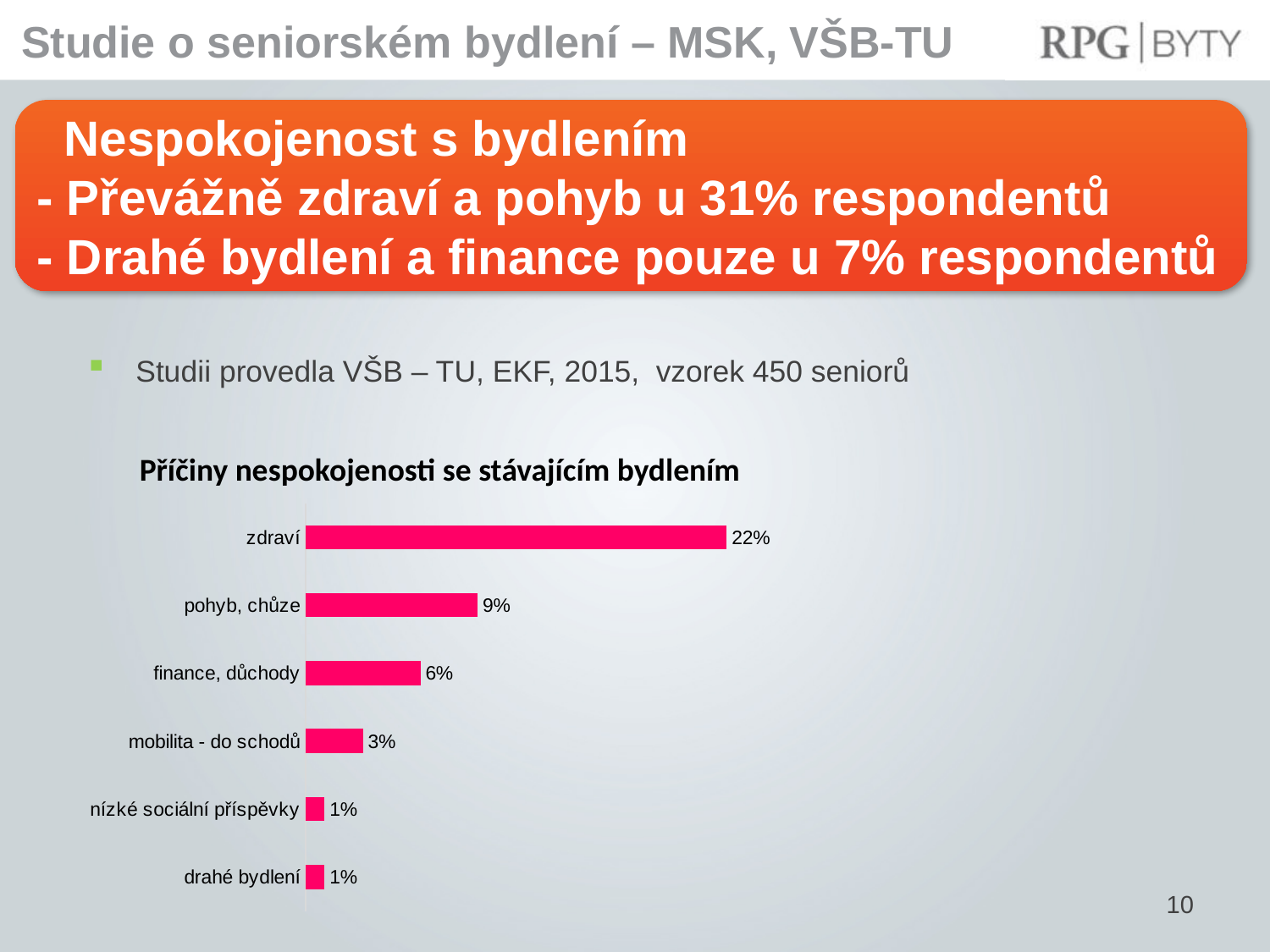
Which is larger, the value for pohyb, chůze or the value for finance, důchody? pohyb, chůze Which category has the highest value? zdraví What is the difference between the values for finance, důchody and mobilita - do schodů? 3% How many categories are shown in the chart? 6 What is the difference between the values for zdraví and pohyb, chůze? 13% What is the value for drahé bydlení? 1% What is the title of the chart? Příčiny nespokojenosti se stávajícím bydlením What is the value for pohyb, chůze? 9% What is the value for zdraví? 22% What is the value for mobilita - do schodů? 3% What is the value for finance, důchody? 6% What kind of chart is shown on the slide? bar chart